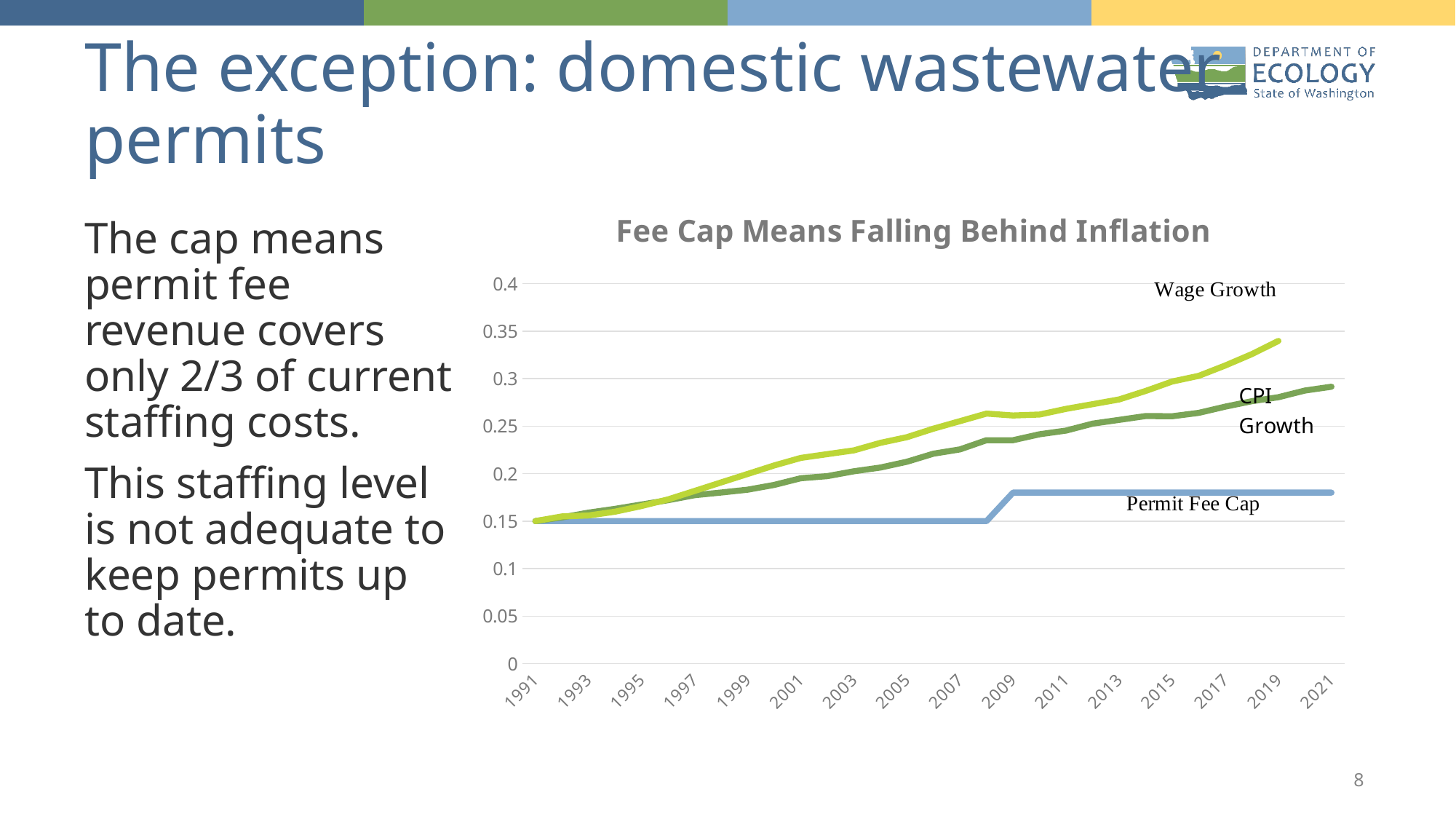
Is the value for Wage Growth in 2019 greater or less than 0.3? greater In 2005, which is higher: Wage Growth or CPI Growth? Wage Growth Is the value for Permit Fee Cap in 2015 greater or less than 0.2? less What kind of chart is shown on the slide? line chart How many year labels are shown on the x axis? 16 Which series has the lowest value in 2021? Permit Fee Cap Which series has the highest value at the right end of the chart? Wage Growth Does the Wage Growth line rise or fall from 1991 to 2019? rise Is the value for CPI Growth in 2001 greater or less than 0.25? less How many series are labelled on the chart? 3 What is the title of the chart? Fee Cap Means Falling Behind Inflation What is the value of the Permit Fee Cap line in 1991? 0.15